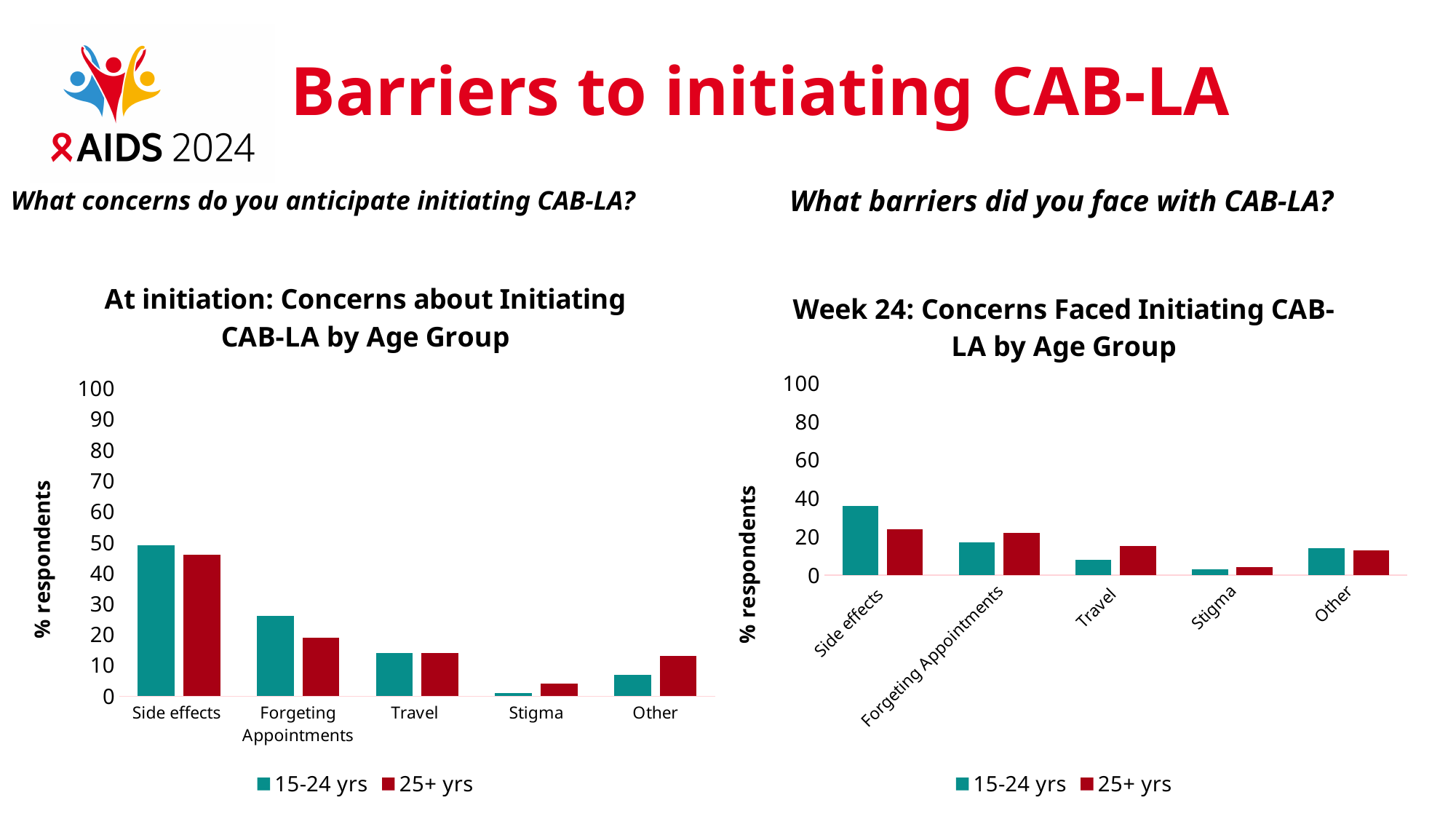
In the 'Week 24' chart, which category has the highest value for 15-24 yrs? Side effects In the 'Week 24' chart, is the value for Stigma among 25+ yrs greater or less than 20? less In the 'Week 24' chart, which age group has the larger value for Travel? 25+ yrs In the 'At initiation' chart, which category has the highest value for 15-24 yrs? Side effects In the 'Week 24' chart, is the value for Side effects among 15-24 yrs greater or less than 20? greater In the 'At initiation' chart, which category has the lowest value for 15-24 yrs? Stigma In the 'At initiation' chart, which age group has the larger value for Forgeting Appointments? 15-24 yrs In the 'At initiation' chart, is the value for Side effects among 15-24 yrs greater or less than 40? greater In the 'At initiation' chart, how many series does the legend list? 2 What kind of chart is the 'At initiation: Concerns about Initiating CAB-LA by Age Group' chart? Bar chart What is the y-axis label on the 'Week 24' chart? % respondents In the 'At initiation' chart, how many concern categories are shown on the x axis? 5